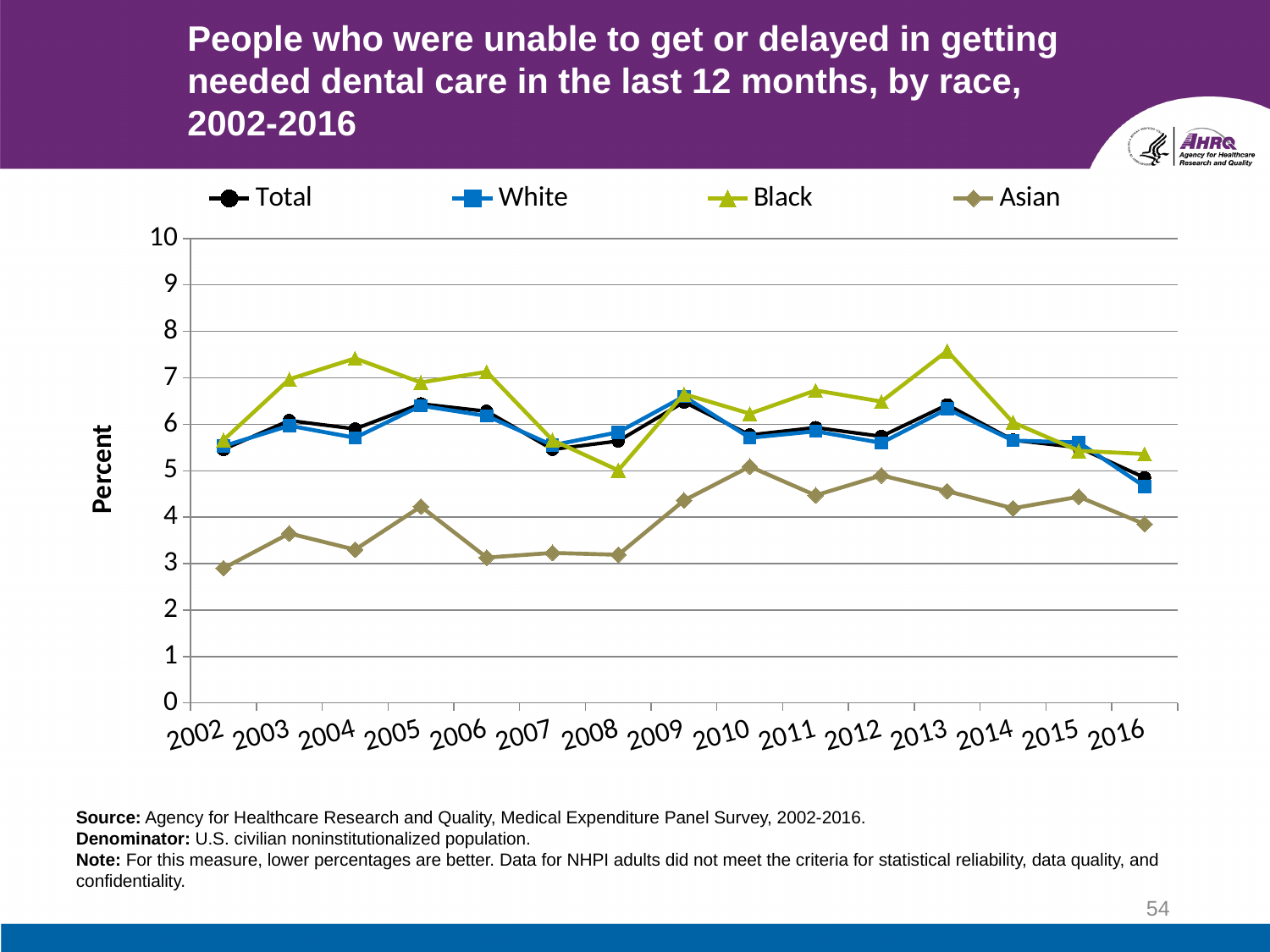
How many series does the legend list? 4 Is the value for Asian in 2002 greater or less than 4? less Does the Black series rise or fall from 2013 to 2016? fall What is the label on the y axis? Percent In which year is the Asian series at its lowest? 2002 How many years are plotted along the x axis? 15 Is the value for Black in 2008 greater or less than 6? less What kind of chart is shown on the slide? line chart In 2008, which is larger, the value for White or the value for Black? White Is the value for Black in 2013 greater or less than 7? greater Which series has the lowest value in 2013? Asian Which series has the highest value in 2013? Black